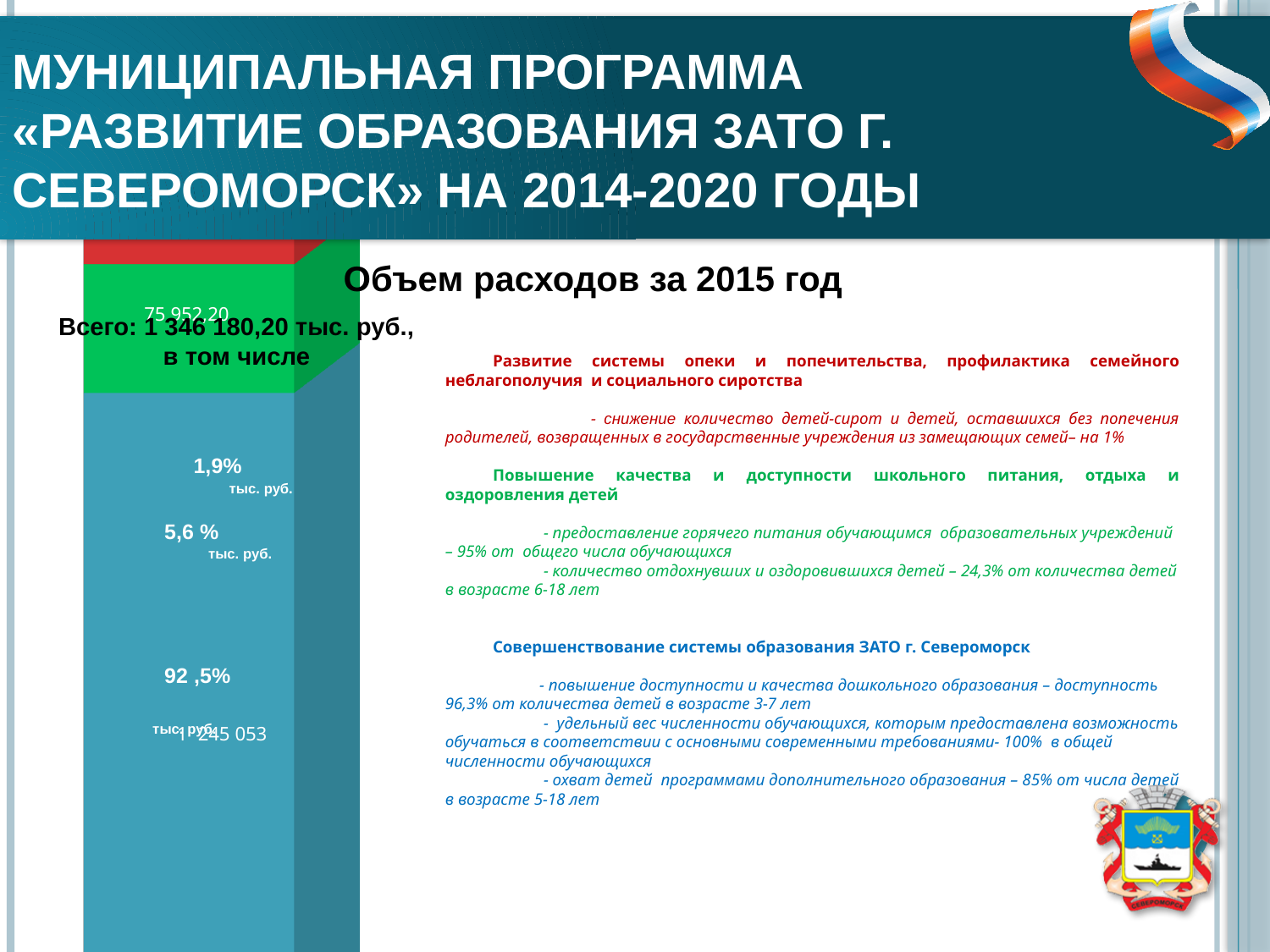
How many segments does the stacked bar have? 3 Which segment of the stacked bar is the smallest? the red segment Which segment of the stacked bar is the largest? the blue segment What colour is the topmost segment of the stacked bar? red What is the title of the chart on the slide? Объем расходов за 2015 год What value is printed on the green segment of the bar? 75 952,20 What kind of chart is shown on the slide? stacked bar chart What is the largest percentage share printed on the chart? 92,5% What is the difference between the blue segment value (1 245 053) and the green segment value (75 952,20)? 1 169 100,80 What value is printed on the blue segment of the bar? 1 245 053 Which segment of the bar is larger, the green one or the blue one? the blue one What is the total value of the stacked bar according to the slide? 1 346 180,20 тыс. руб.